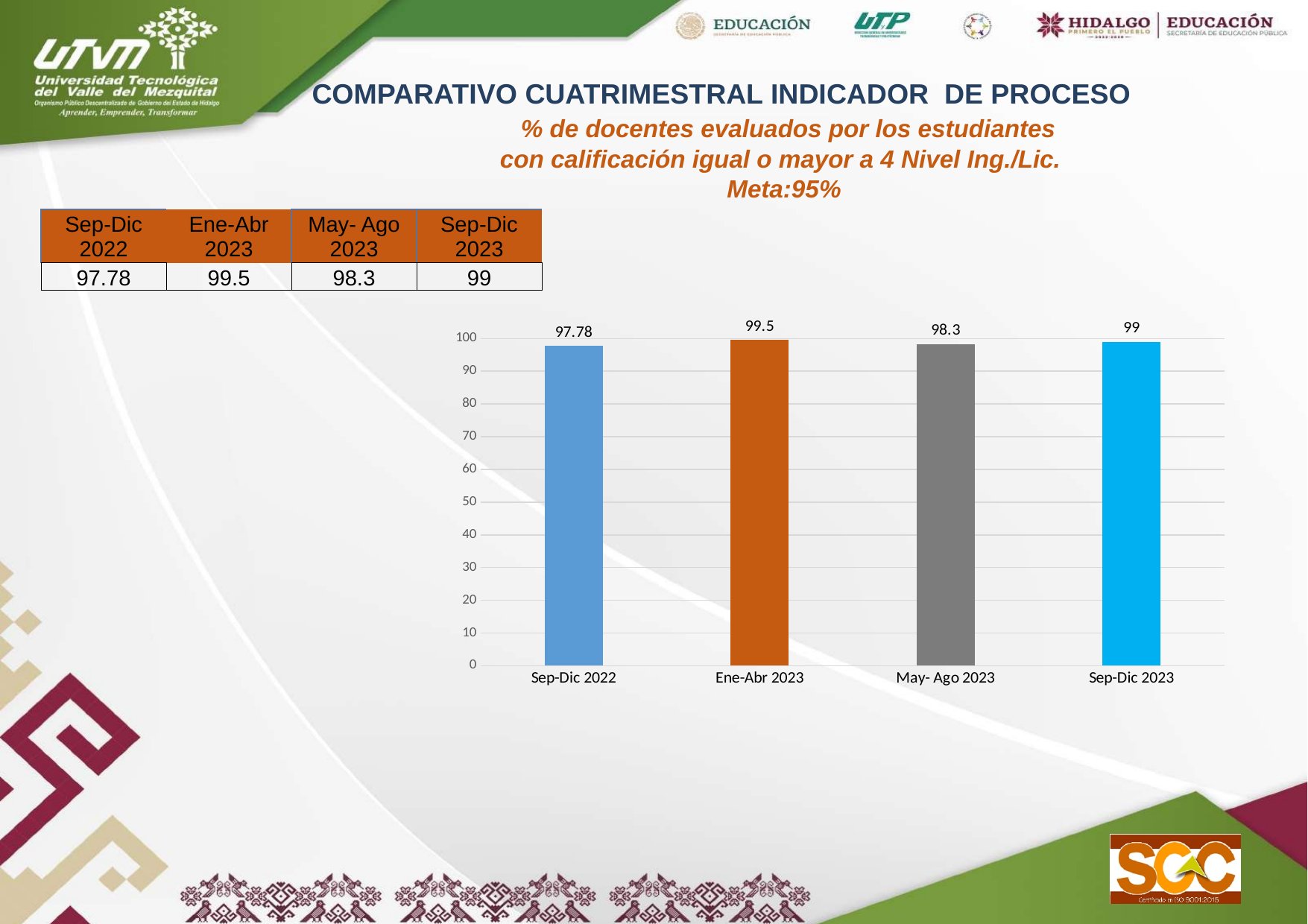
Which is larger, the value for Ene-Abr 2023 or the value for Sep-Dic 2023? Ene-Abr 2023 What is the value for Ene-Abr 2023? 99.5 What is the value for Sep-Dic 2023? 99 What kind of chart is shown on the slide? Bar chart Which period has the lowest value? Sep-Dic 2022 What is the difference between the values for Ene-Abr 2023 and Sep-Dic 2022? 1.72 What is the value for Sep-Dic 2022? 97.78 What is the difference between the values for Sep-Dic 2023 and May- Ago 2023? 0.7 How many periods are shown on the chart? 4 Which period has the highest value? Ene-Abr 2023 What is the value for May- Ago 2023? 98.3 What is the target (Meta) stated on the slide? 95%